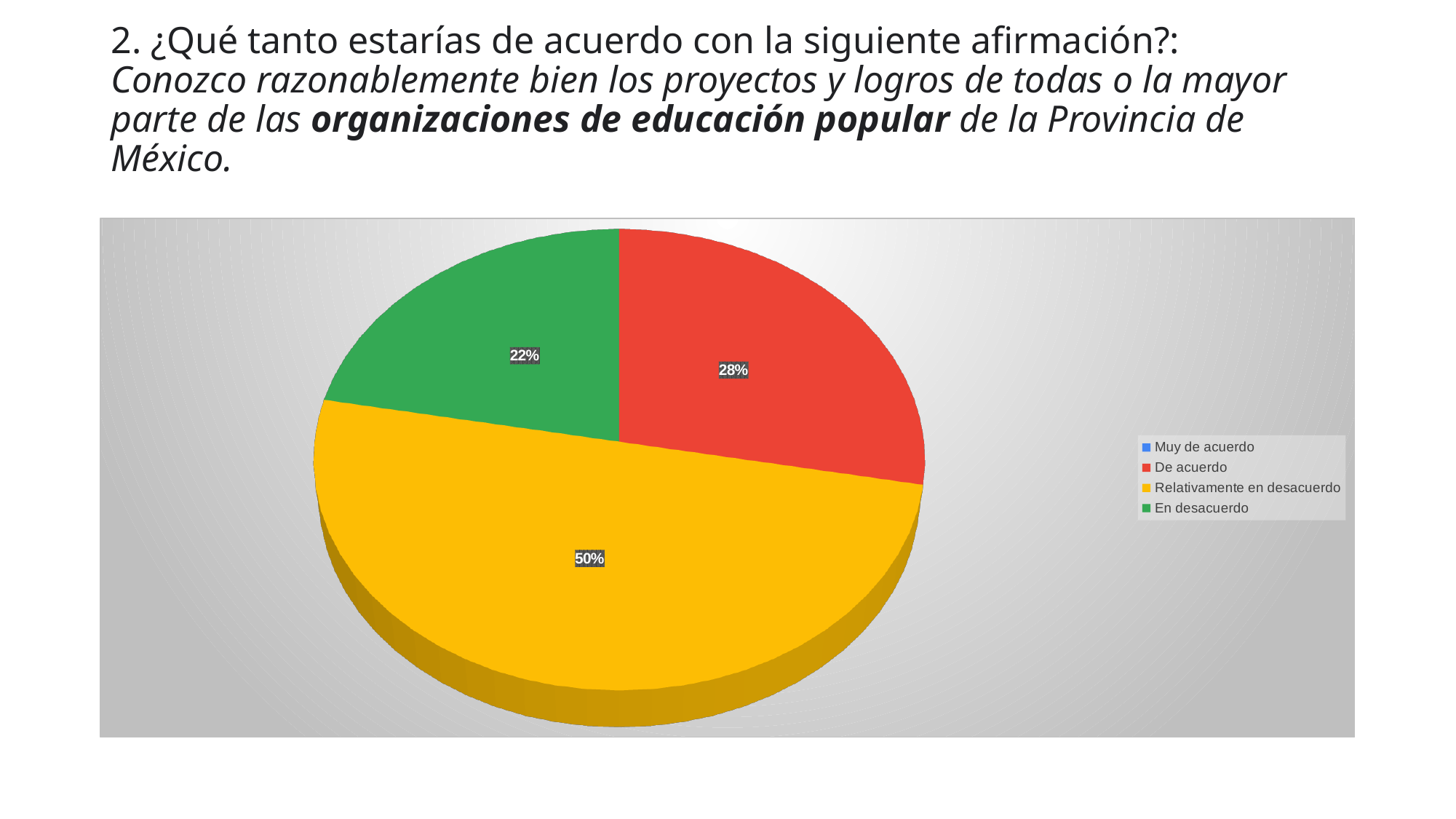
How many slices with percentage labels are visible in the pie? 3 What is the difference in percentage points between "Relativamente en desacuerdo" and "De acuerdo"? 22 How many entries does the legend list? 4 What kind of chart is shown on the slide? Pie chart What is the difference in percentage points between "De acuerdo" and "En desacuerdo"? 6 What percentage of the pie is labelled for "Relativamente en desacuerdo"? 50% Which of the visible slices is the smallest? En desacuerdo Which slice is larger, "De acuerdo" or "En desacuerdo"? De acuerdo What percentage of the pie is labelled for "En desacuerdo"? 22% What colour is the "Relativamente en desacuerdo" slice? Yellow Which category has the largest slice of the pie? Relativamente en desacuerdo What percentage of the pie is labelled for "De acuerdo"? 28%